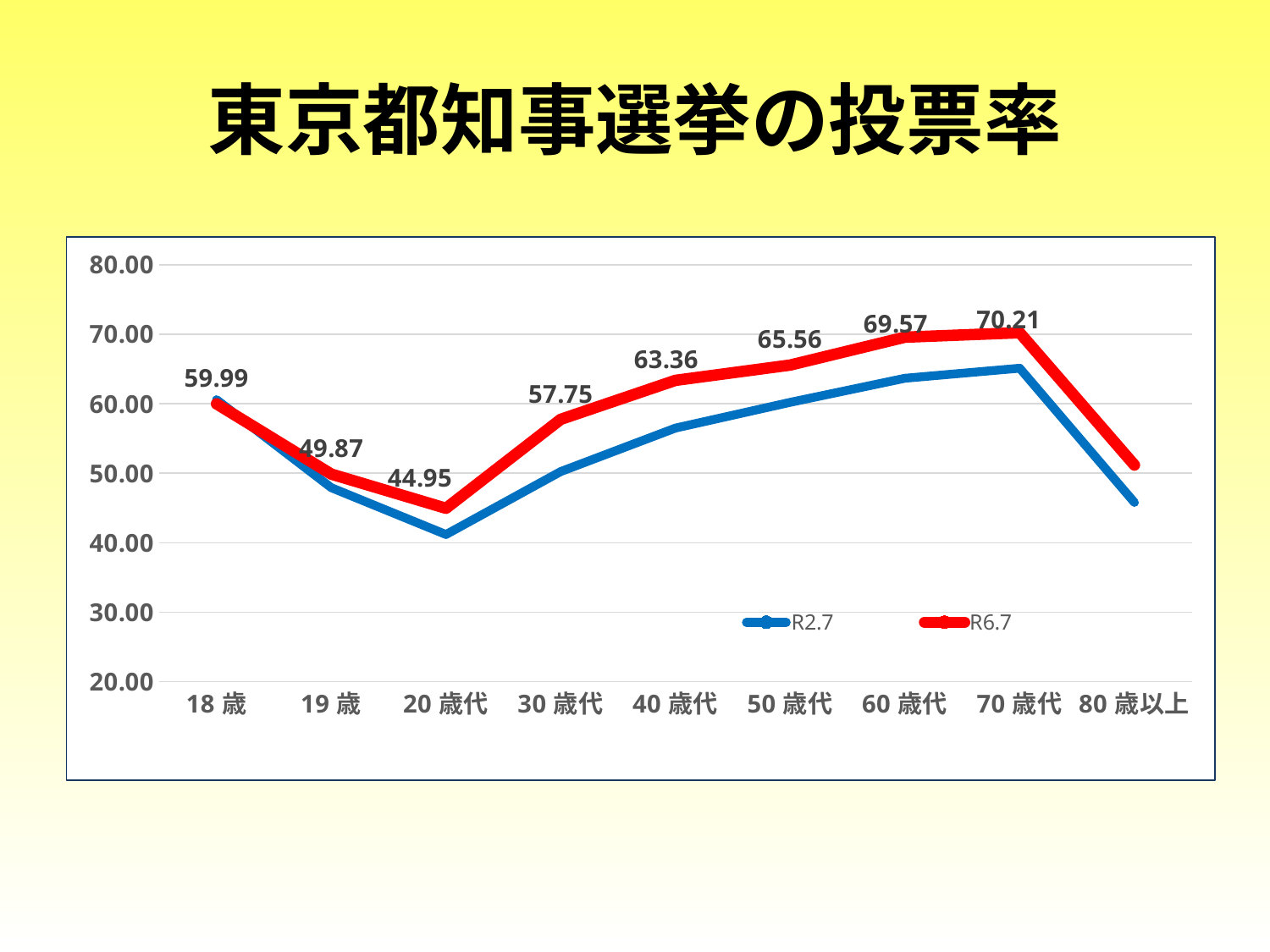
What type of chart is shown on the slide? line chart How many series does the legend list? 2 Which age category has the highest R6.7 value? 70 歳代 Which series is higher at 40 歳代, R2.7 or R6.7? R6.7 What is the title of the chart? 東京都知事選挙の投票率 What is the R6.7 value for 70 歳代? 70.21 What is the R6.7 value for 20 歳代? 44.95 How many age categories are shown on the x axis? 9 What is the difference between the R6.7 values for 70 歳代 and 20 歳代? 25.26 Which age category has the lowest R6.7 value? 20 歳代 Is the R2.7 value for 20 歳代 greater or less than 50.00? less What is the R6.7 value for 18 歳? 59.99